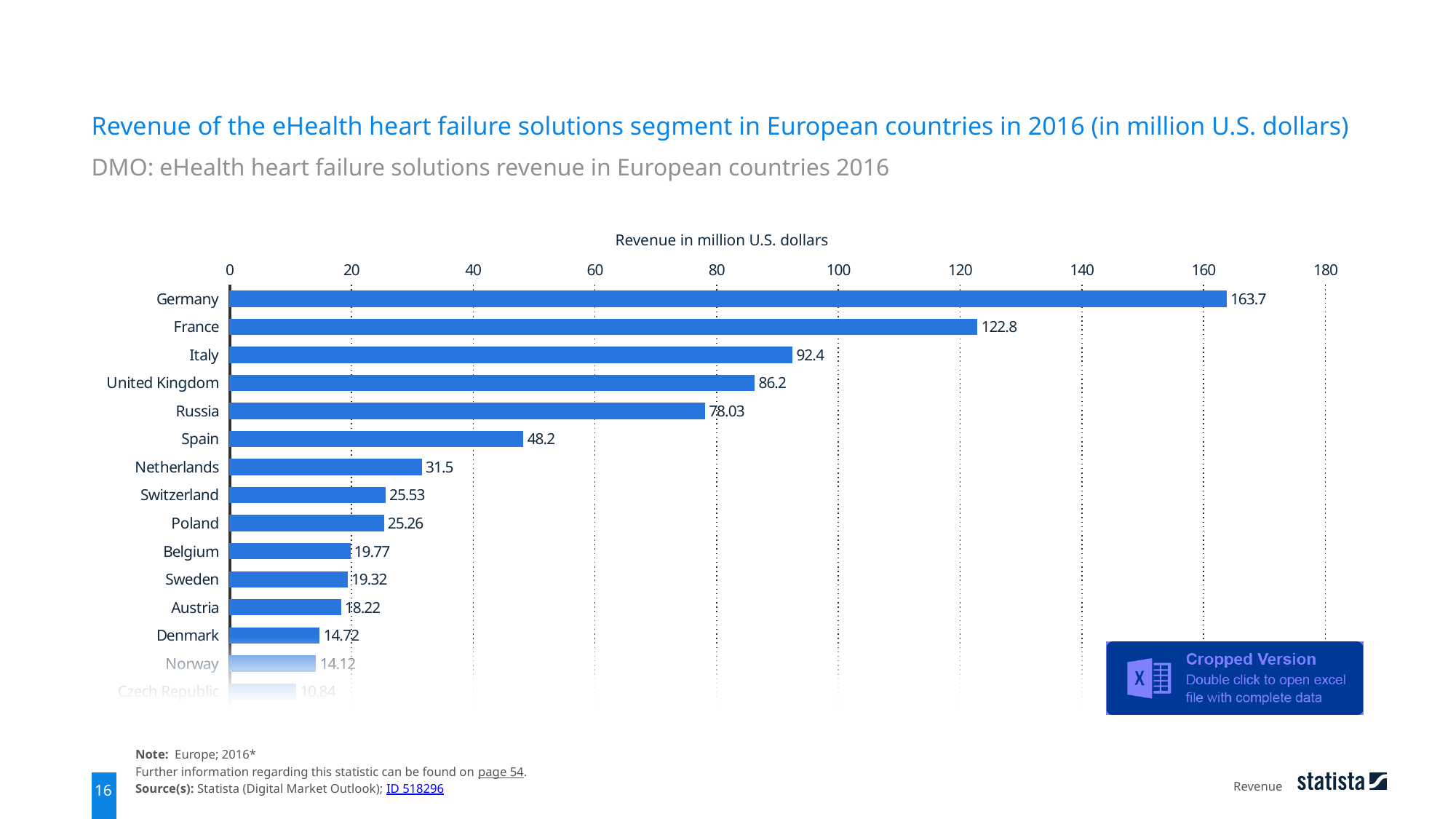
Which has a larger revenue, Spain or Netherlands? Spain Is the value for Russia greater or less than 80? less What is the difference in revenue between Italy and the United Kingdom? 6.2 What is the revenue for Denmark? 14.72 What is the revenue for Switzerland? 25.53 Which country has the highest revenue? Germany What is the label of the horizontal axis? Revenue in million U.S. dollars Which has a larger revenue, France or Italy? France What is the revenue for Russia? 78.03 What is the difference in revenue between Germany and France? 40.9 What kind of chart is shown on the slide? Bar chart What is the revenue for Germany? 163.7